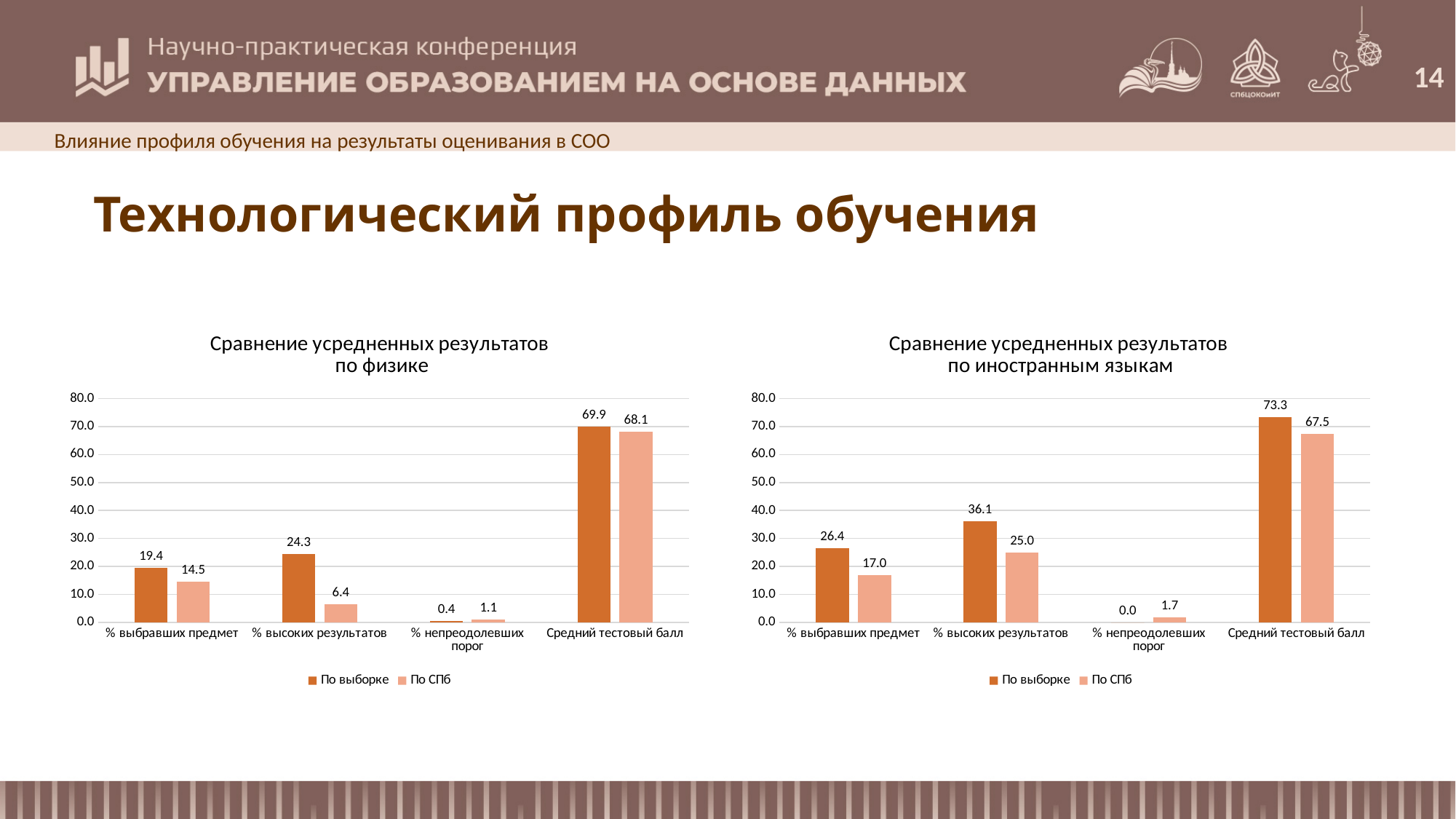
What type of chart is 'Сравнение усредненных результатов по физике'? Bar chart In the chart 'Сравнение усредненных результатов по физике', what is the difference between 'По выборке' and 'По СПб' for '% высоких результатов'? 17.9 In the chart 'Сравнение усредненных результатов по иностранным языкам', what is the difference between 'По выборке' and 'По СПб' for '% выбравших предмет'? 9.4 How many series does the legend of the chart 'Сравнение усредненных результатов по иностранным языкам' list? 2 In the chart 'Сравнение усредненных результатов по иностранным языкам', which category has the lowest value for 'По СПб'? % непреодолевших порог In the chart 'Сравнение усредненных результатов по иностранным языкам', what is the value of 'По выборке' for 'Средний тестовый балл'? 73.3 In the chart 'Сравнение усредненных результатов по иностранным языкам', what is the value of 'По СПб' for '% непреодолевших порог'? 1.7 In the chart 'Сравнение усредненных результатов по физике', which category has the highest value for 'По выборке'? Средний тестовый балл In the chart 'Сравнение усредненных результатов по физике', what is the value of 'По СПб' for '% высоких результатов'? 6.4 In the chart 'Сравнение усредненных результатов по физике', what is the value of 'По выборке' for '% выбравших предмет'? 19.4 How many categories are shown on the x axis of the chart 'Сравнение усредненных результатов по физике'? 4 In the chart 'Сравнение усредненных результатов по иностранным языкам', which is larger for '% высоких результатов': 'По выборке' or 'По СПб'? По выборке